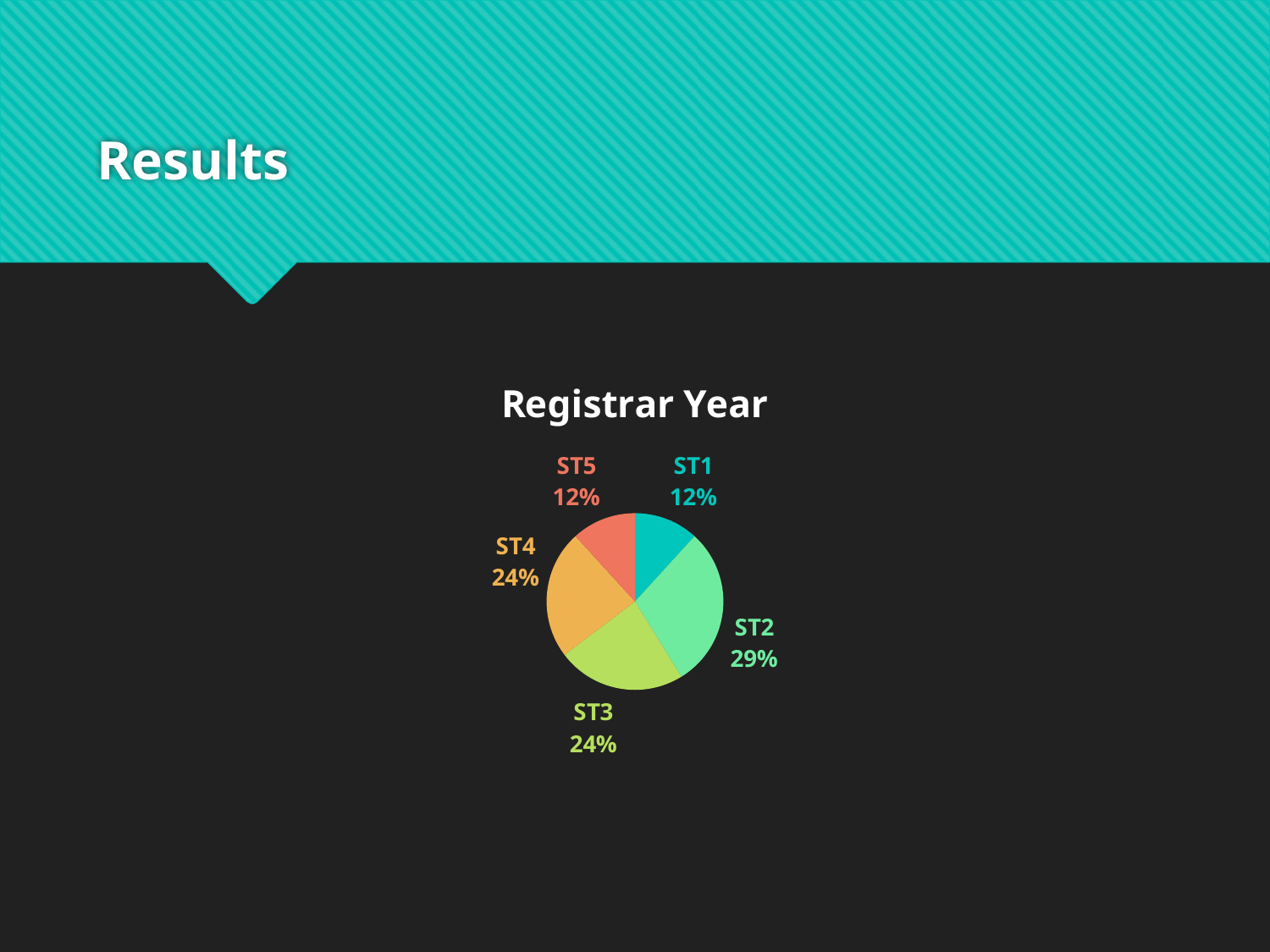
How many slices does the pie chart have? 5 Which is larger, the share for ST3 or the share for ST1? ST3 What type of chart is shown on the slide? pie chart Which two categories share the same smallest percentage? ST1 and ST5 What percentage of the pie does ST2 represent? 29% What colour is the ST5 slice? red/coral What percentage of the pie does ST4 represent? 24% Which category has the largest share of the pie? ST2 What percentage of the pie does ST1 represent? 12% What is the difference in percentage points between ST2 and ST5? 17 What is the combined share of ST3 and ST4? 48% What is the title of the chart? Registrar Year